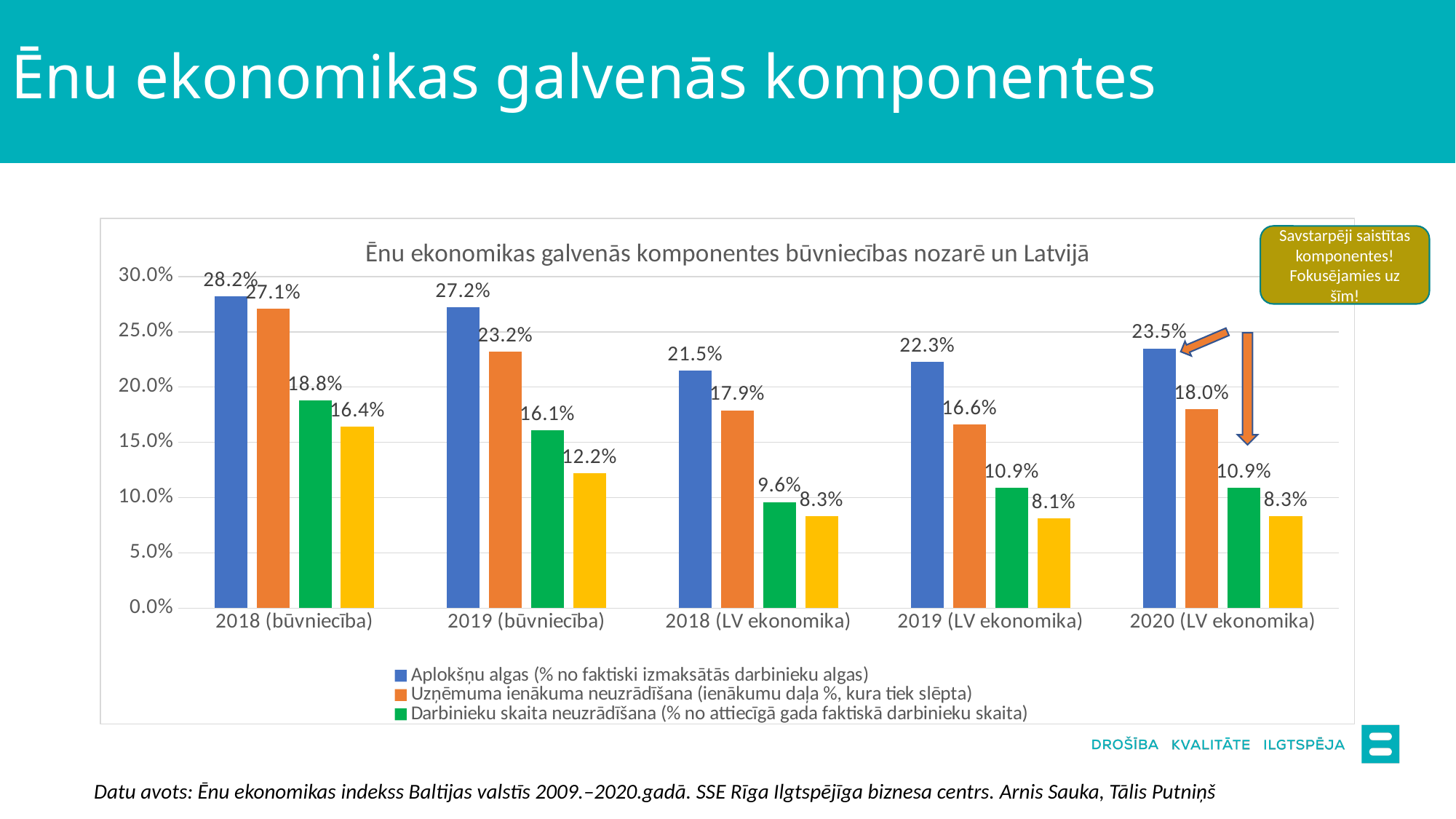
What type of chart is shown on the slide? Bar chart What is the value of Aplokšņu algas for 2018 (būvniecība)? 28.2% What is the value of Aplokšņu algas for 2020 (LV ekonomika)? 23.5% Is the value of Aplokšņu algas for 2019 (LV ekonomika) greater or less than 20.0%? greater How many categories are shown on the x axis? 5 What is the difference between Aplokšņu algas and Uzņēmuma ienākuma neuzrādīšana for 2020 (LV ekonomika)? 5.5% How many series does the legend list? 3 What is the value of Uzņēmuma ienākuma neuzrādīšana for 2019 (būvniecība)? 23.2% Which is larger: Darbinieku skaita neuzrādīšana for 2018 (būvniecība) or for 2019 (būvniecība)? 2018 (būvniecība) What is the value of Darbinieku skaita neuzrādīšana for 2018 (LV ekonomika)? 9.6% Which category has the lowest value for Uzņēmuma ienākuma neuzrādīšana? 2019 (LV ekonomika) Which category has the highest value for Aplokšņu algas? 2018 (būvniecība)